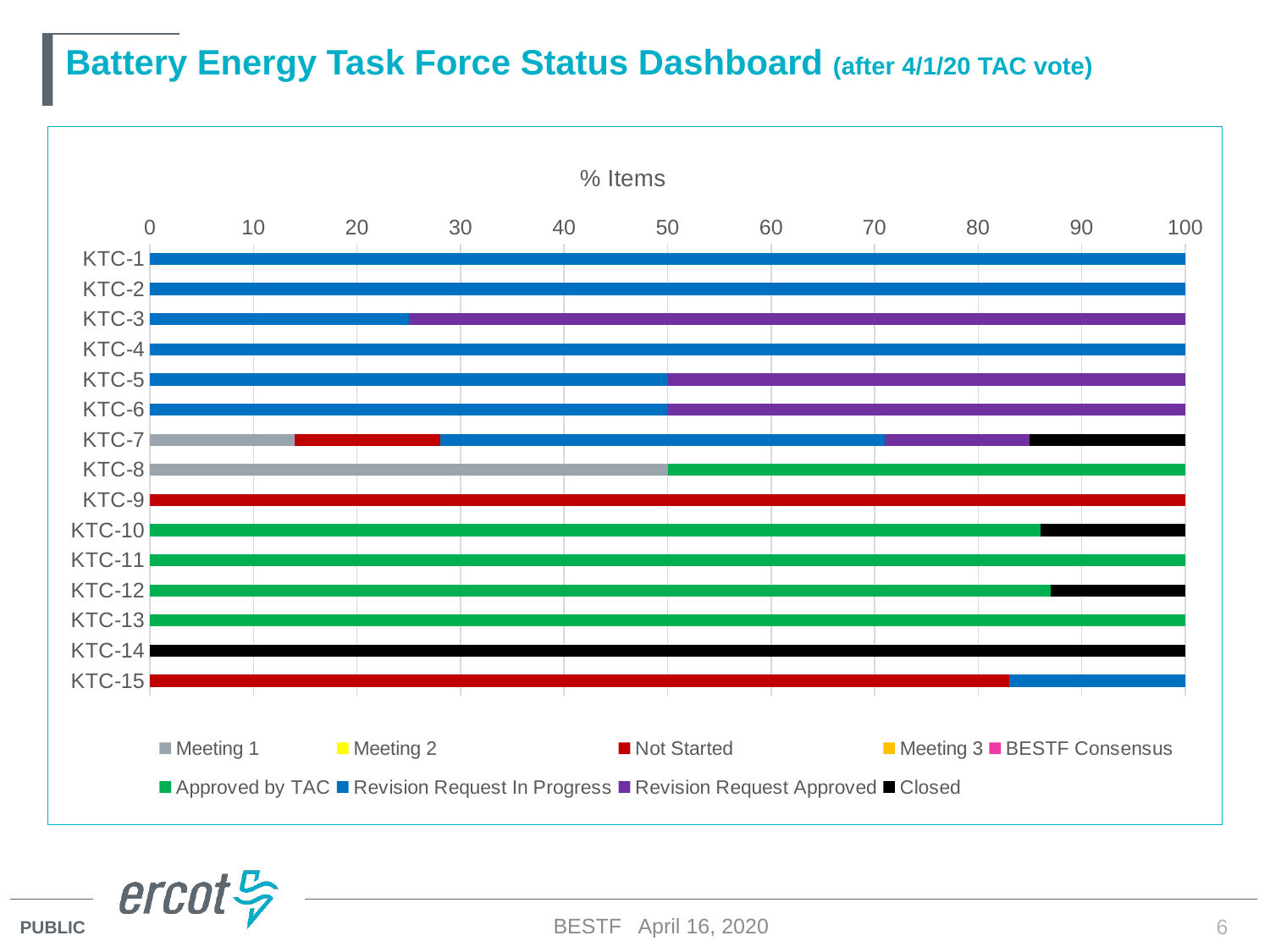
Is the Not Started value for KTC-15 greater or less than 80? greater How many series does the chart legend list? 9 Is the Revision Request In Progress value for KTC-3 greater or less than 30? less What is the Meeting 1 value for KTC-8? 50 What is the total of the stacked bar for KTC-14? 100 Which series is shown in black in the legend? Closed What is the title of the chart? % Items Is the Meeting 1 value for KTC-7 greater or less than 20? less Which has the larger Meeting 1 value, KTC-7 or KTC-8? KTC-8 How many KTC categories are plotted on the chart? 15 What kind of chart is shown on the slide? Bar chart What is the Revision Request In Progress value for KTC-5? 50